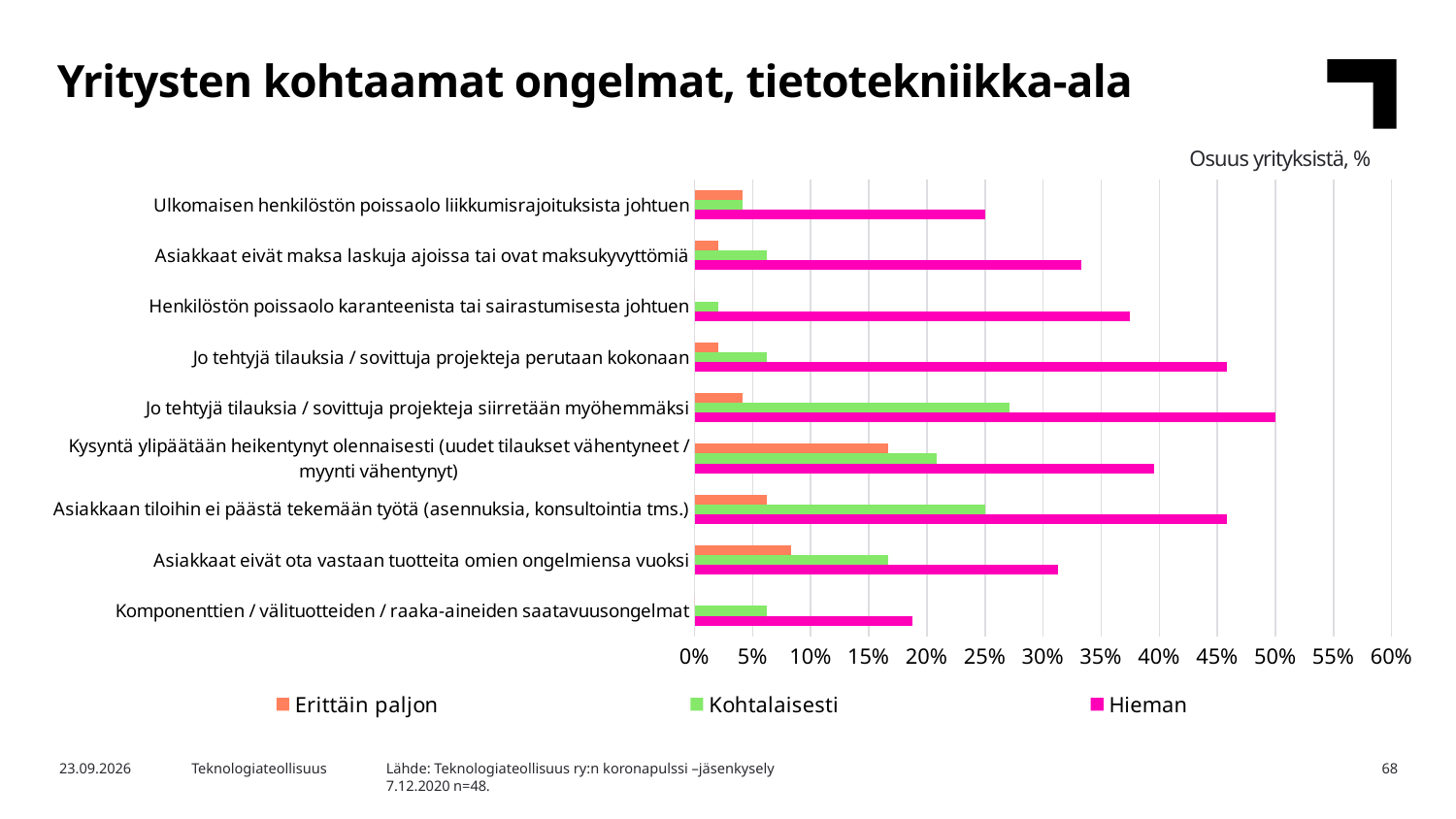
Which category has the highest value for the 'Hieman' series? Jo tehtyjä tilauksia / sovittuja projekteja siirretään myöhemmäksi Which category has the highest value for the 'Erittäin paljon' series? Kysyntä ylipäätään heikentynyt olennaisesti (uudet tilaukset vähentyneet / myynti vähentynyt) Is the 'Hieman' value for 'Henkilöstön poissaolo karanteenista tai sairastumisesta johtuen' greater or less than 35%? greater For the 'Hieman' series, which is larger: 'Ulkomaisen henkilöstön poissaolo liikkumisrajoituksista johtuen' or 'Komponenttien / välituotteiden / raaka-aineiden saatavuusongelmat'? Ulkomaisen henkilöstön poissaolo liikkumisrajoituksista johtuen Which category has the lowest value for the 'Hieman' series? Komponenttien / välituotteiden / raaka-aineiden saatavuusongelmat Is the 'Hieman' value for 'Komponenttien / välituotteiden / raaka-aineiden saatavuusongelmat' greater or less than 20%? less Is the 'Erittäin paljon' value for 'Kysyntä ylipäätään heikentynyt olennaisesti' greater or less than 15%? greater What are the three series named in the legend? Erittäin paljon, Kohtalaisesti, Hieman How many series does the legend list? 3 How many problem categories are plotted on the chart? 9 What kind of chart is shown on the slide? Bar chart